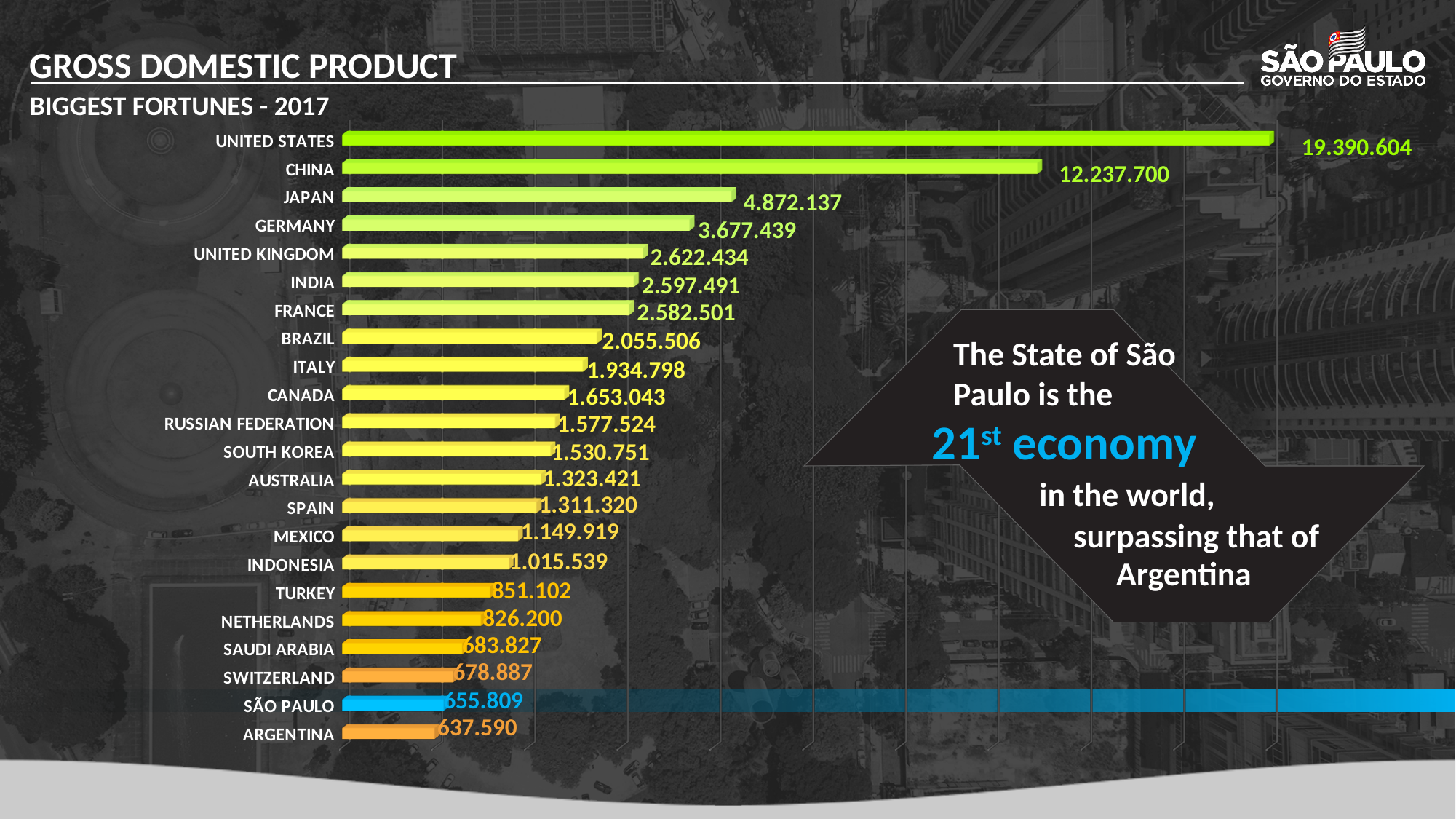
What is the subtitle of the chart below 'Gross Domestic Product'? Biggest Fortunes - 2017 What is the value shown for the Russian Federation? 1.577.524 What kind of chart is shown on the slide? Bar chart Which has a larger value, Brazil or Italy? Brazil What is the value shown for Netherlands? 826.200 What is the value shown for Japan? 4.872.137 How many categories are shown in the chart? 22 Which category has the highest value? United States Which category has the lowest value? Argentina What is the value shown for São Paulo? 655.809 What is the difference between the values for the United States and China? 7.152.904 What is the difference between the values for São Paulo and Argentina? 18.219